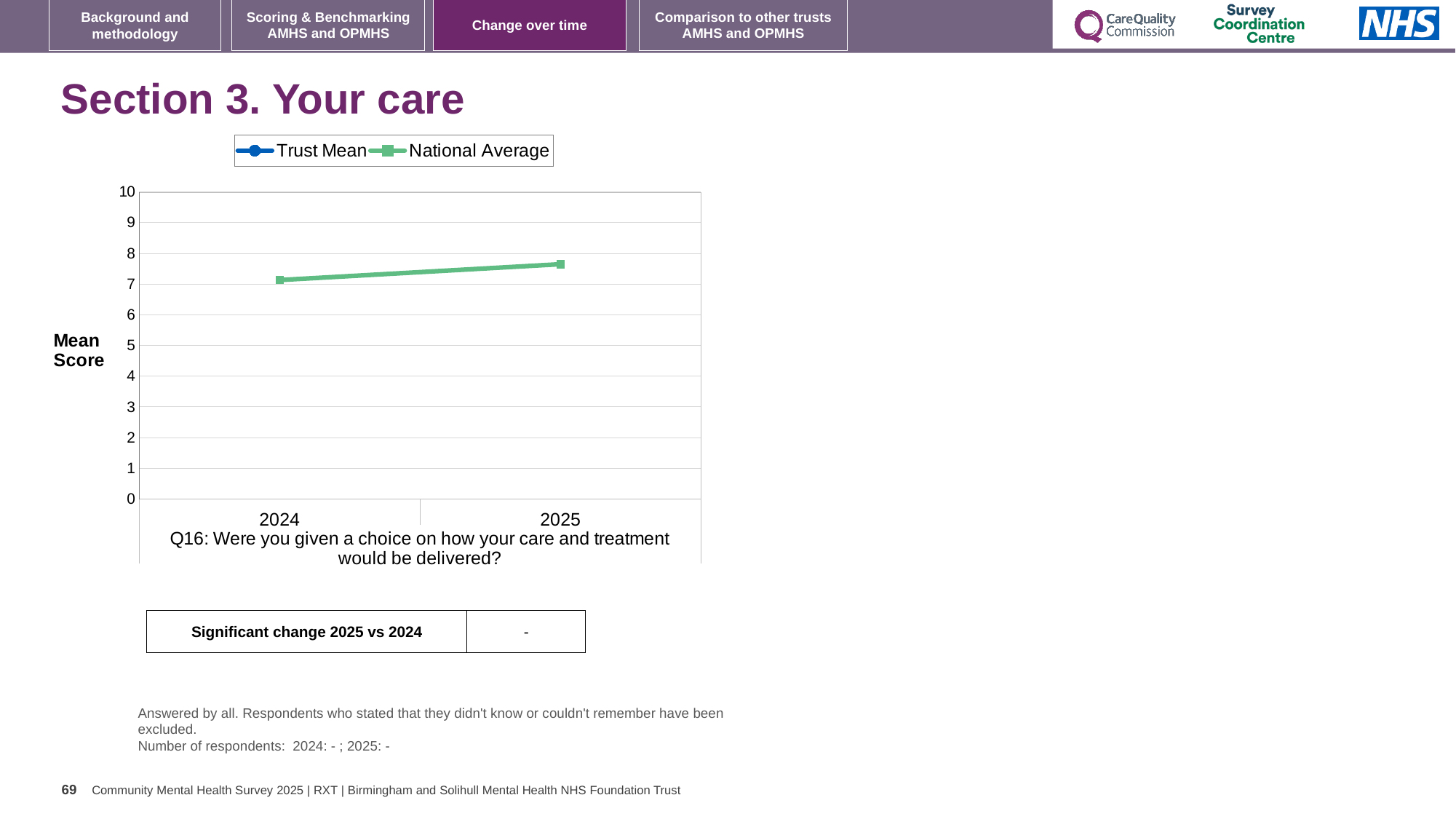
Does the National Average line rise or fall from 2024 to 2025? rise Is the National Average value for 2024 greater or less than 8? less What are the two series named in the legend? Trust Mean and National Average What is the maximum value shown on the y axis? 10 Which year has the higher National Average value, 2024 or 2025? 2025 Is the National Average value for 2025 greater or less than 8? less Is the National Average value for 2025 greater or less than 7? greater What kind of chart is shown on the slide? line chart What is the label on the y axis of the chart? Mean Score How many years are shown on the x axis? 2 How many series does the legend list? 2